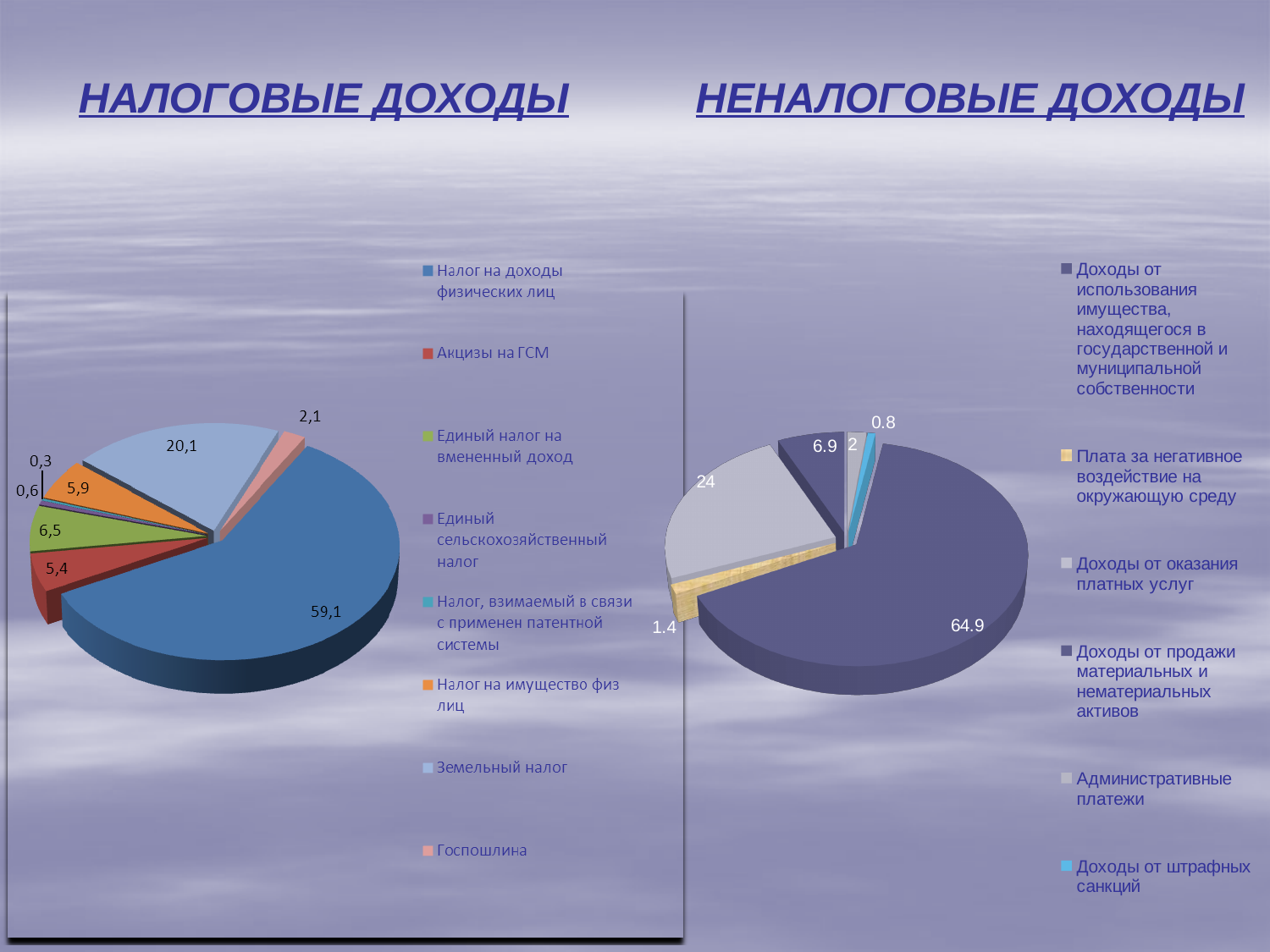
In the НАЛОГОВЫЕ ДОХОДЫ chart, which is larger: Налог на имущество физ лиц or Госпошлина? Налог на имущество физ лиц In the НАЛОГОВЫЕ ДОХОДЫ chart, how many categories does the legend list? 8 In the НАЛОГОВЫЕ ДОХОДЫ chart, what is the difference between Единый налог на вмененный доход and Акцизы на ГСМ? 1,1 In the НЕНАЛОГОВЫЕ ДОХОДЫ chart, what is the value for Доходы от штрафных санкций? 0.8 In the НЕНАЛОГОВЫЕ ДОХОДЫ chart, which category has the largest slice? Доходы от использования имущества, находящегося в государственной и муниципальной собственности In the НЕНАЛОГОВЫЕ ДОХОДЫ chart, how many slices are there? 6 In the НЕНАЛОГОВЫЕ ДОХОДЫ chart, what is the difference between Доходы от продажи материальных и нематериальных активов and Административные платежи? 4.9 In the НАЛОГОВЫЕ ДОХОДЫ chart, what is the value for Налог на доходы физических лиц? 59,1 In the НАЛОГОВЫЕ ДОХОДЫ chart, what is the value for Земельный налог? 20,1 What type of chart is used for НАЛОГОВЫЕ ДОХОДЫ? Pie chart In the НЕНАЛОГОВЫЕ ДОХОДЫ chart, what is the value for Доходы от оказания платных услуг? 24 In the НАЛОГОВЫЕ ДОХОДЫ chart, which category has the smallest slice? Налог, взимаемый в связи с применен патентной системы